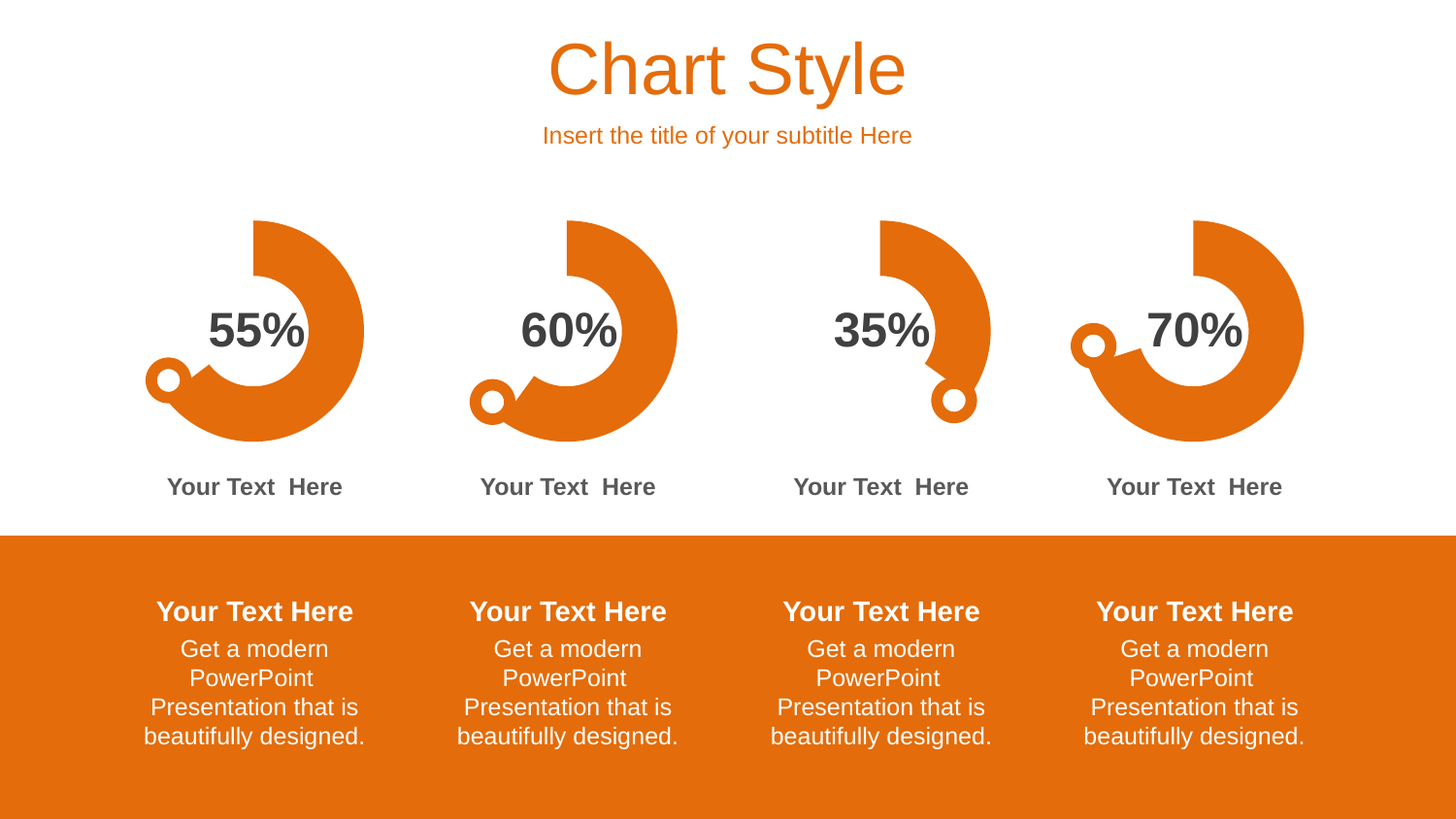
What value is shown in the first (leftmost) donut chart? 55% What kind of chart is used to display the percentages on this slide? Donut chart How many donut charts are shown on the slide? 4 Which of the four donut charts shows the highest percentage? The fourth (rightmost), 70% What is the difference between the value in the rightmost donut chart and the value in the leftmost donut chart? 15% What is the title of the slide? Chart Style What is the difference between the values in the second and third donut charts from the left? 25% What value is shown in the fourth (rightmost) donut chart? 70% What value is shown in the third donut chart from the left? 35% Which is larger, the value in the first donut chart or the value in the second donut chart? The second (60%) Which of the four donut charts shows the lowest percentage? The third from the left, 35% What value is shown in the second donut chart from the left? 60%